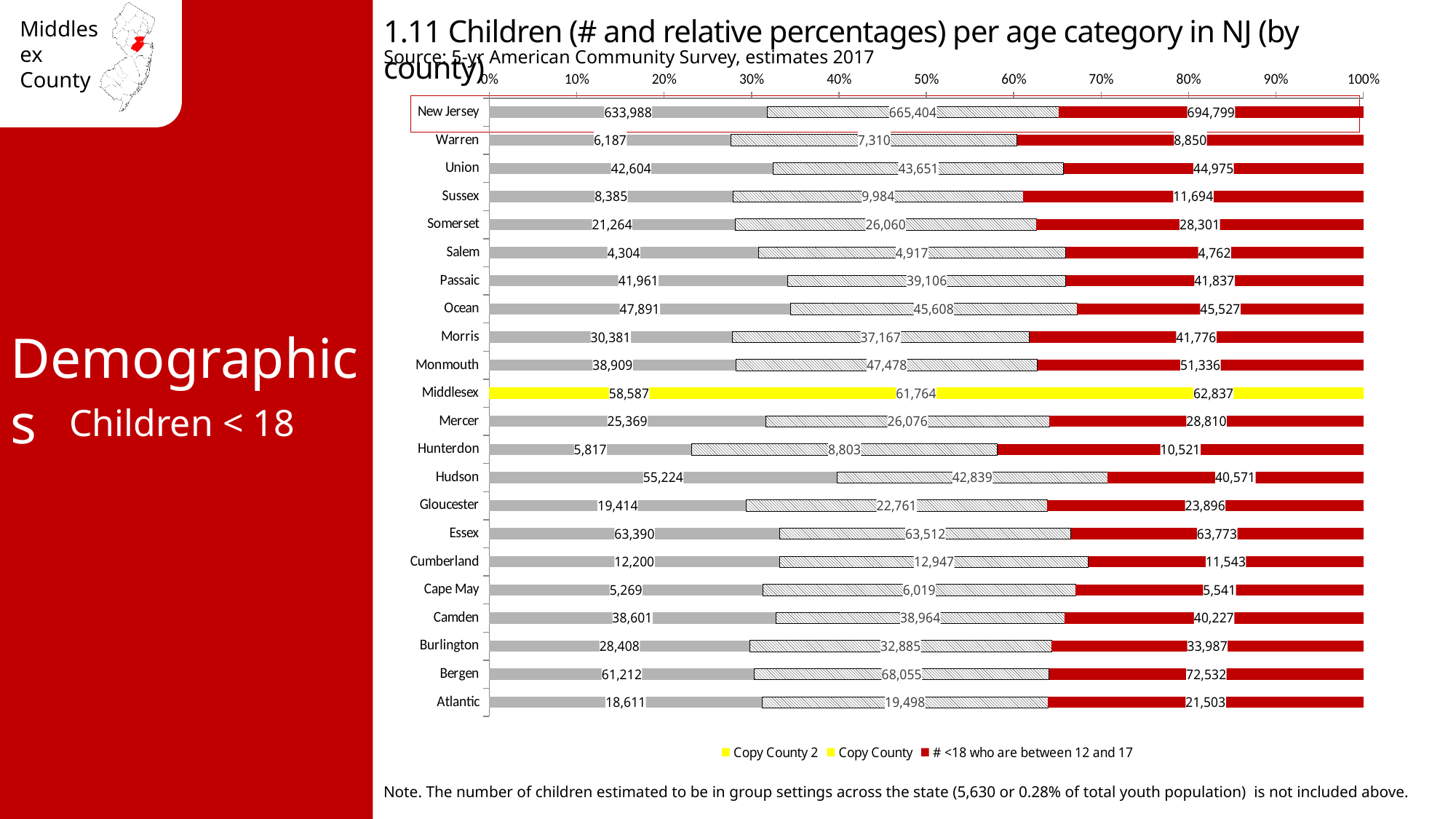
Excluding the New Jersey total row, which county has the highest value in the '# <18 who are between 12 and 17' series? Bergen Which county has the lowest value in the '# <18 who are between 12 and 17' series? Salem What is the value for New Jersey in the '# <18 who are between 12 and 17' series? 694,799 For Middlesex, what is the difference between the '# <18 who are between 12 and 17' value and the first (gray) segment value? 4,250 For Hudson, which is larger: the first (gray) segment or the '# <18 who are between 12 and 17' segment? the first (gray) segment How many rows (counties plus the state total) are shown on the chart? 22 Which county's bar is highlighted in yellow? Middlesex What is the value of the first (gray) segment for Hudson? 55,224 What is the value for Middlesex in the '# <18 who are between 12 and 17' series? 62,837 Does the first (gray) segment for Hunterdon end at a share greater or less than 30%? less How many series does the legend list? 3 What is the total of the three segments for Middlesex? 183,188